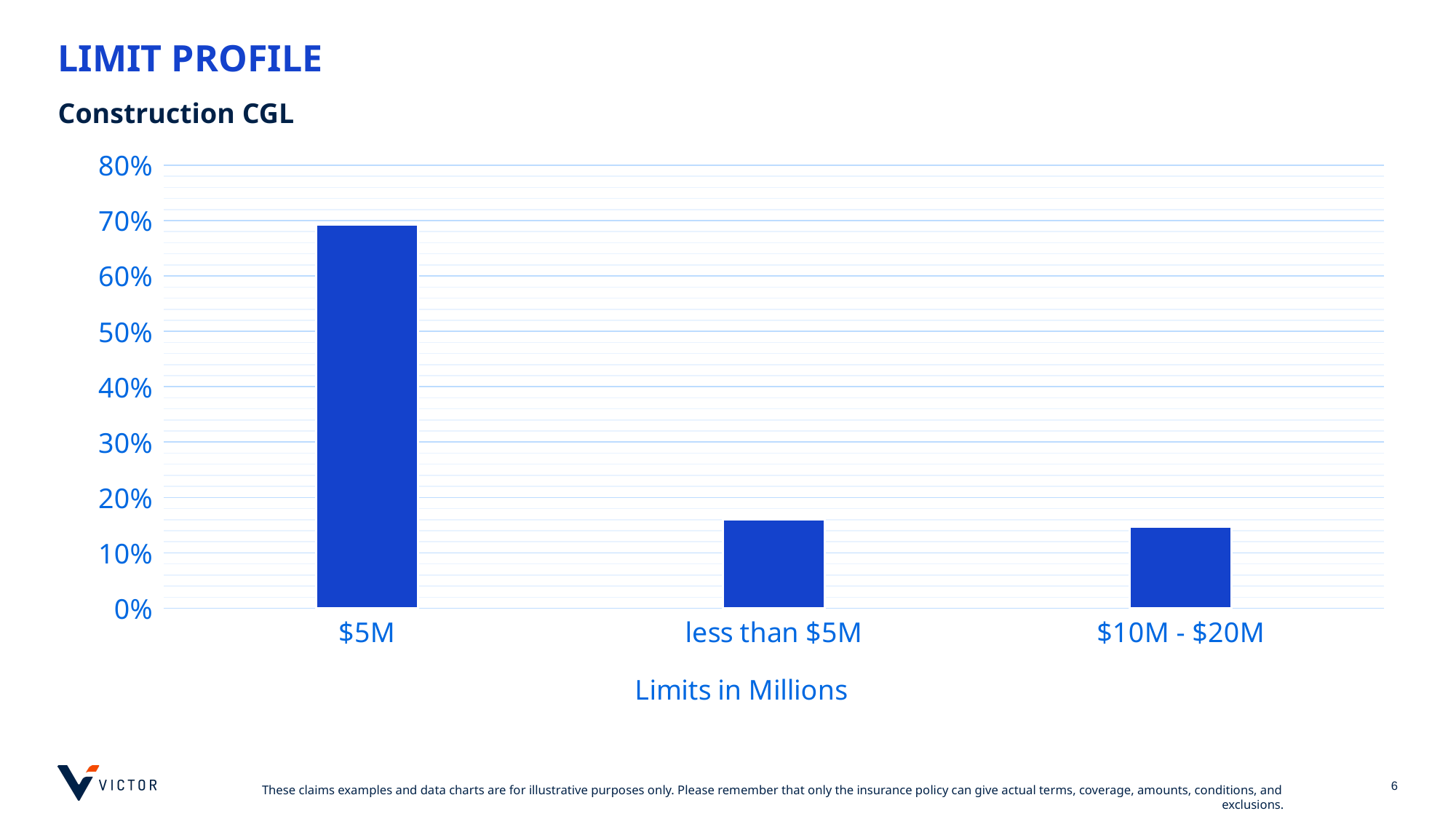
Which is larger, the value for $5M or the value for less than $5M? $5M What kind of chart is shown on the slide? bar chart Is the value for $10M - $20M greater or less than 20%? less Is the value for $10M - $20M greater or less than 10%? greater Is the value for $5M greater or less than 60%? greater What is the highest value shown on the y axis of the chart? 80% Which limit category has the highest value in the chart? $5M How many categories are shown on the x axis of the chart? 3 What is the title of the x axis of the chart? Limits in Millions